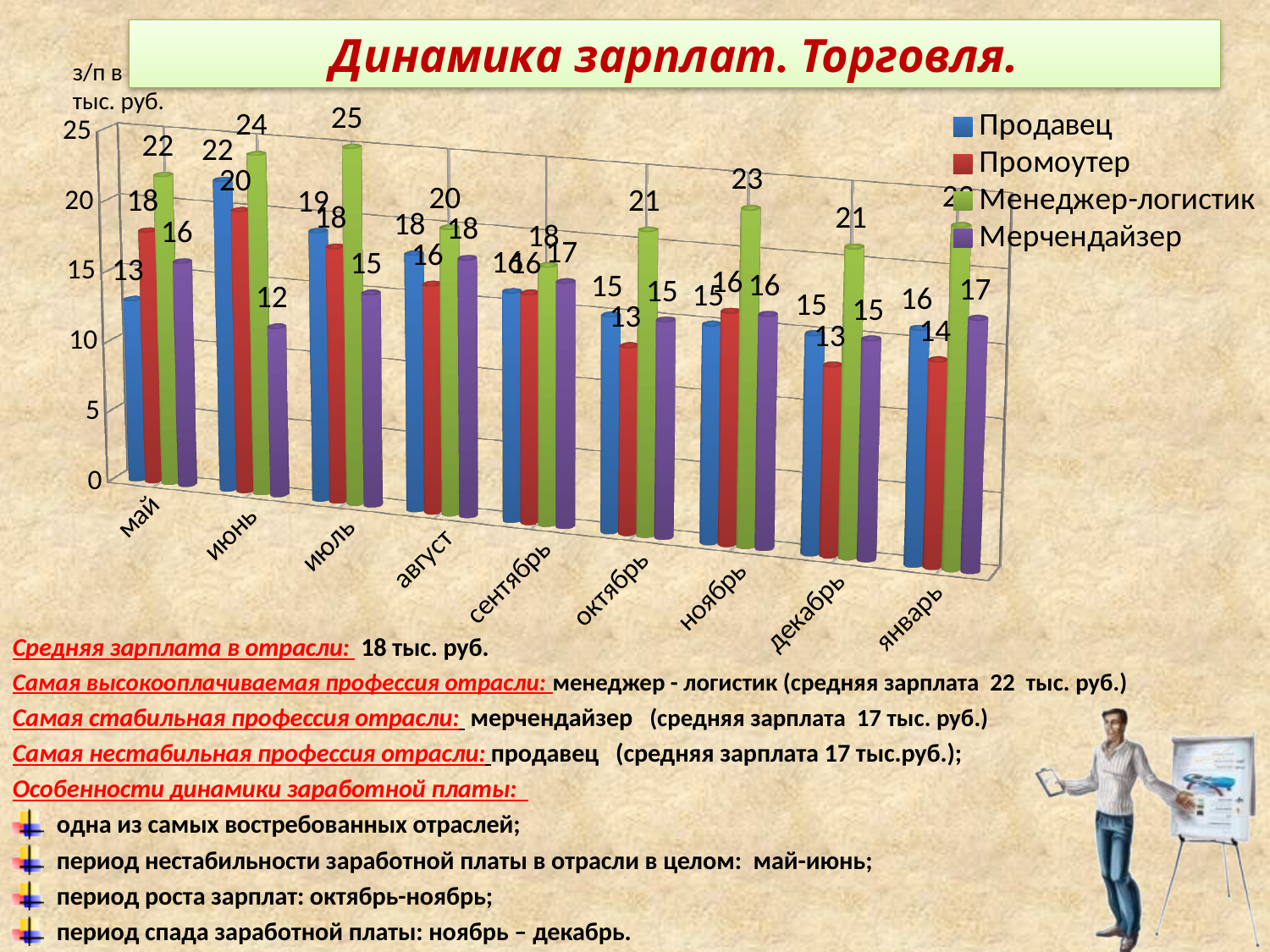
What is the value for Промоутер in октябрь? 13 How many months are shown on the x axis? 9 What kind of chart is shown on the slide? bar chart Does the value for Менеджер-логистик rise or fall from май to июль? rise In which month is the value for Мерчендайзер the lowest? июнь In июнь, which is larger: the value for Продавец or for Промоутер? Продавец How many series does the legend list? 4 In which month is the value for Продавец the highest? июнь In which month is the value for Менеджер-логистик the highest? июль What is the value for Менеджер-логистик in июль? 25 In май, what is the difference between the values for Менеджер-логистик and Продавец? 9 What is the value for Мерчендайзер in июнь? 12